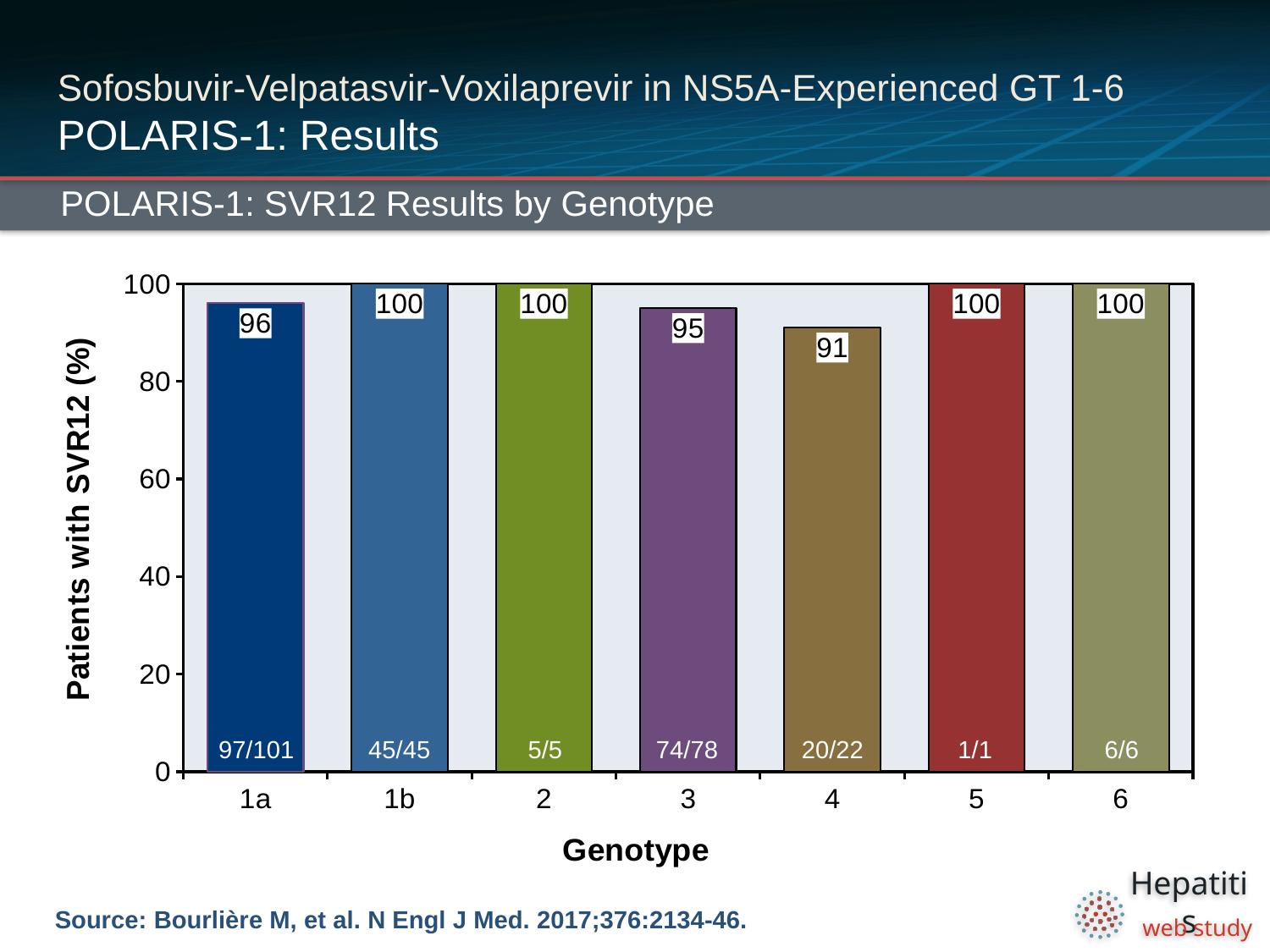
Which genotype has the lowest SVR12 rate? 4 What fraction of patients is shown at the base of the bar for genotype 3? 74/78 How many genotypes have an SVR12 rate of 100? 4 How many genotype categories are shown on the x axis? 7 What is the SVR12 rate for genotype 1a? 96 What is the title of the chart? POLARIS-1: SVR12 Results by Genotype What kind of chart is shown on the slide? Bar chart What is the label of the y axis? Patients with SVR12 (%) What is the SVR12 rate for genotype 3? 95 Which has a higher SVR12 rate, genotype 1a or genotype 3? 1a What is the SVR12 rate for genotype 4? 91 What is the difference in SVR12 rate between genotype 1b and genotype 4? 9